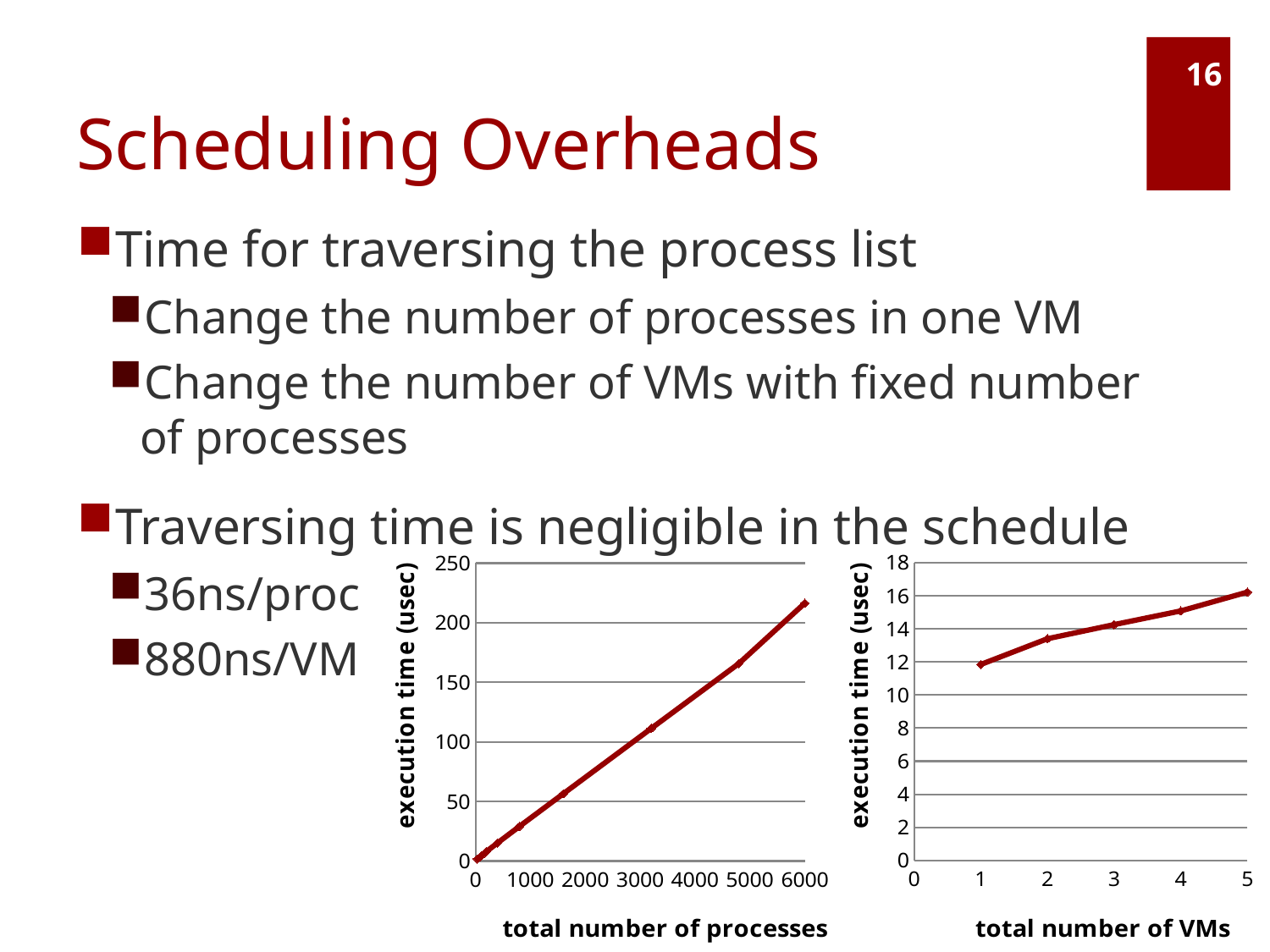
In the right chart, is the execution time at 4 VMs greater or less than 14? greater What kind of chart is the left chart (execution time vs total number of processes)? line chart In the left chart, is the execution time at 6000 processes greater or less than 200? greater In the right chart, is the execution time at 2 VMs greater or less than 12? greater What is the x-axis title of the left chart? total number of processes In the left chart, does execution time rise or fall as the total number of processes increases? rise In the right chart, does execution time rise or fall as the total number of VMs increases? rise In the right chart, how many data points are plotted? 5 In the right chart, at which number of VMs is the execution time highest? 5 What kind of chart is the right chart (execution time vs total number of VMs)? line chart